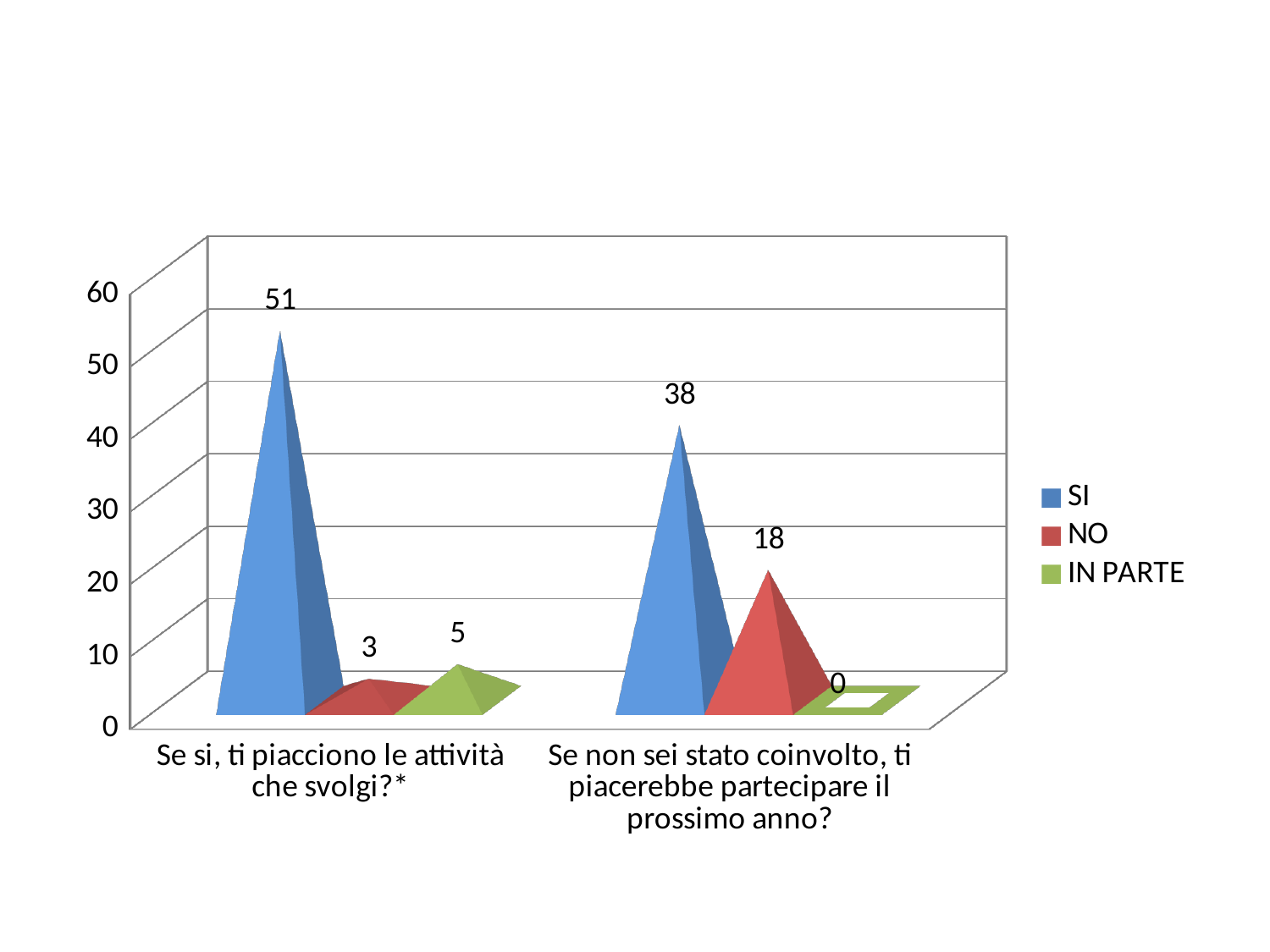
Which series has the highest value in the category "Se si, ti piacciono le attività che svolgi?*"? SI What is the difference between the SI values of the two categories? 13 What is the value for IN PARTE in the category "Se non sei stato coinvolto, ti piacerebbe partecipare il prossimo anno?"? 0 What colour represents the NO series in the legend? Red What is the difference between SI and NO in the category "Se non sei stato coinvolto, ti piacerebbe partecipare il prossimo anno?"? 20 What is the value for SI in the category "Se si, ti piacciono le attività che svolgi?*"? 51 Which is larger: NO for "Se si, ti piacciono le attività che svolgi?*" or NO for "Se non sei stato coinvolto, ti piacerebbe partecipare il prossimo anno?"? Se non sei stato coinvolto, ti piacerebbe partecipare il prossimo anno? What is the value for IN PARTE in the category "Se si, ti piacciono le attività che svolgi?*"? 5 Which series has the lowest value in the category "Se non sei stato coinvolto, ti piacerebbe partecipare il prossimo anno?"? IN PARTE What is the value for NO in the category "Se non sei stato coinvolto, ti piacerebbe partecipare il prossimo anno?"? 18 How many categories are shown on the x axis? 2 How many series does the legend list? 3